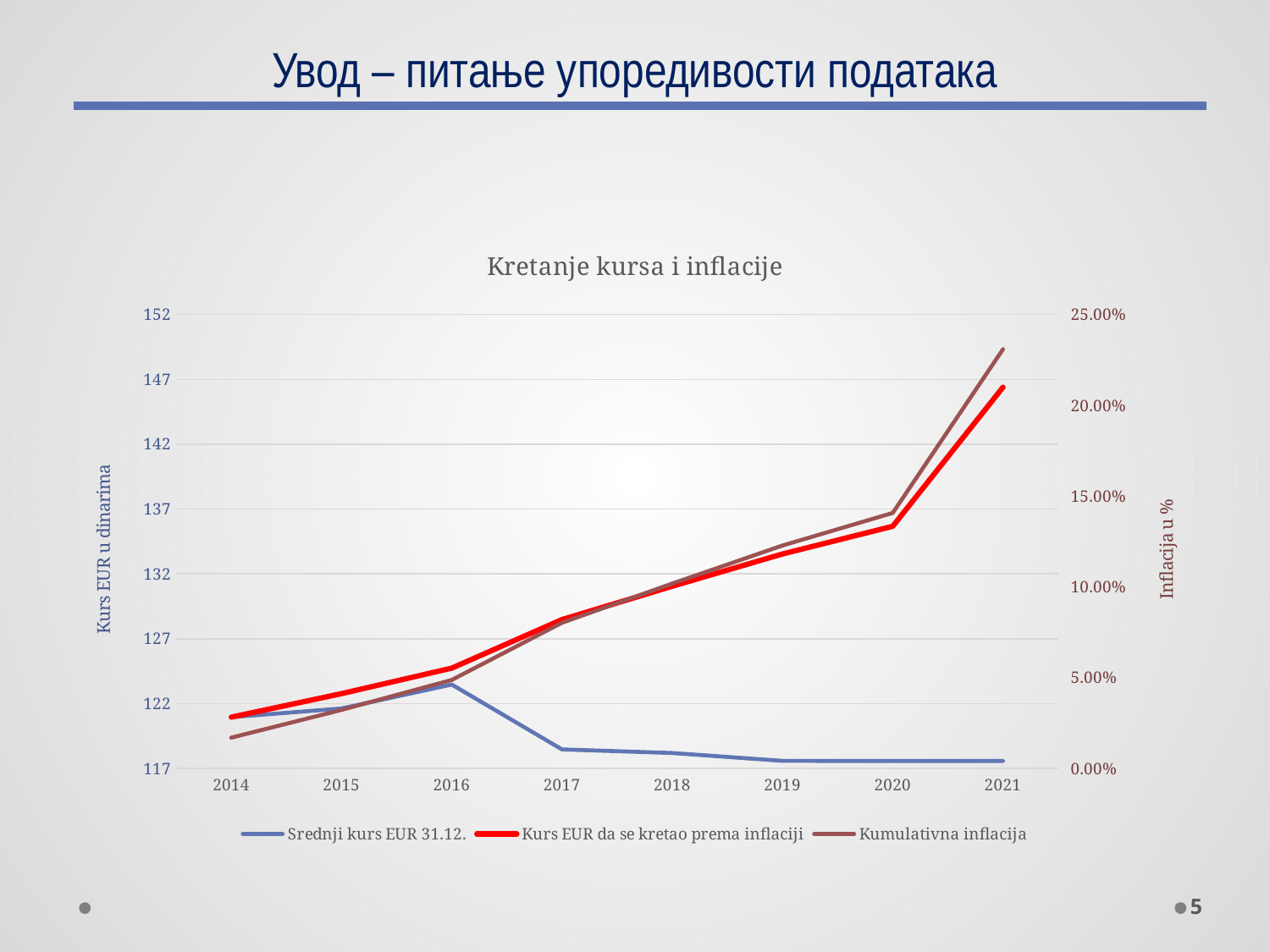
Is the value for 'Srednji kurs EUR 31.12.' in 2021 greater or less than 122? less How many years are shown on the x axis? 8 In which year is the 'Srednji kurs EUR 31.12.' series at its highest? 2016 In which year is the 'Kumulativna inflacija' series at its lowest? 2014 What kind of chart is shown on the slide? Line chart Which is larger for 'Srednji kurs EUR 31.12.': the value in 2016 or the value in 2021? 2016 Does the 'Kumulativna inflacija' series rise or fall from 2014 to 2021? rise In which year is the 'Kurs EUR da se kretao prema inflaciji' series at its highest? 2021 What is the title of the chart? Kretanje kursa i inflacije How many series does the legend list? 3 What is the label of the left vertical axis? Kurs EUR u dinarima Is the value for 'Kumulativna inflacija' in 2021 greater or less than 20.00%? greater